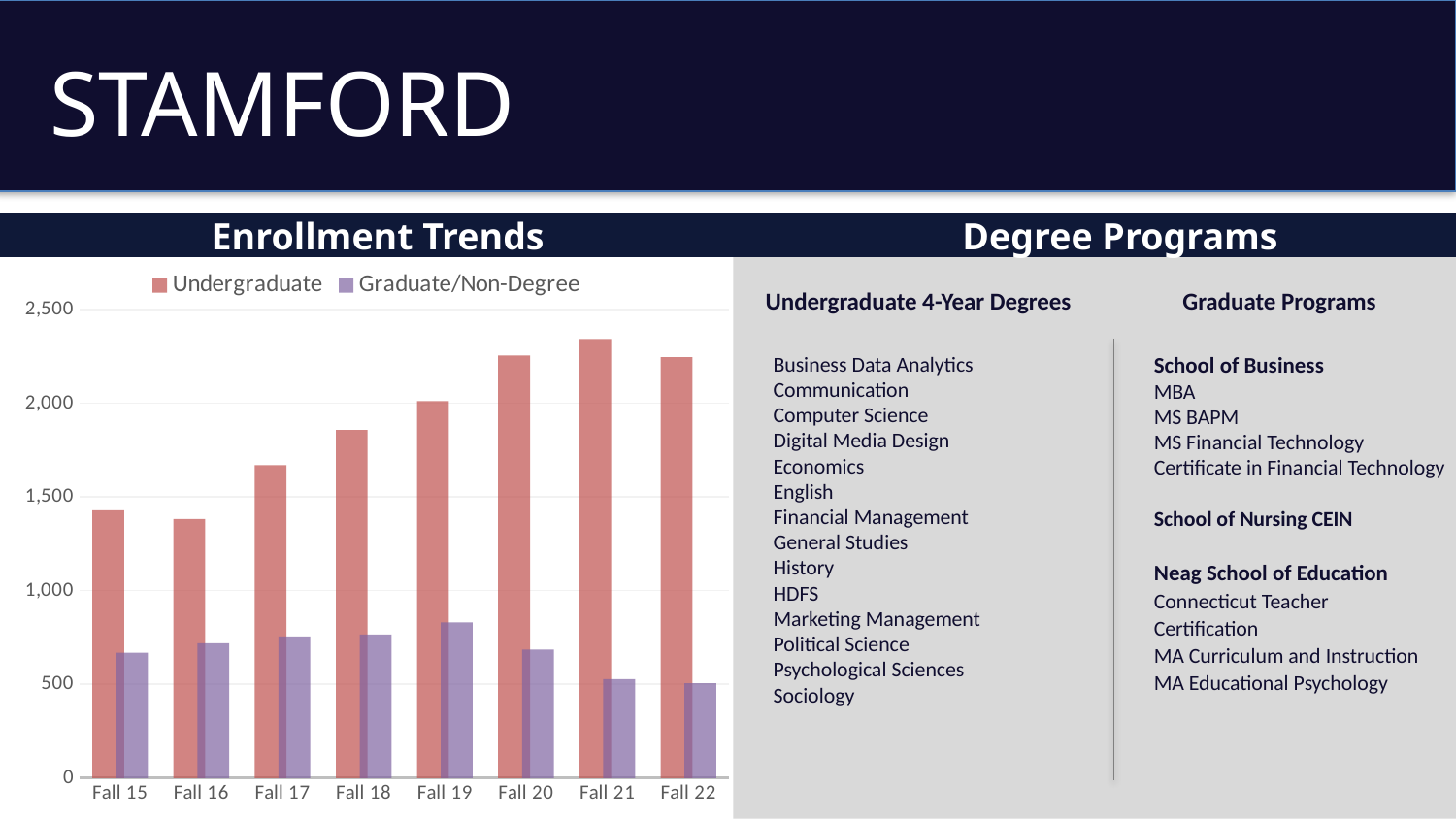
Which is larger: Graduate/Non-Degree enrollment in Fall 19 or in Fall 21? Fall 19 In which semester is Undergraduate enrollment highest in the Enrollment Trends chart? Fall 21 How many semesters are shown on the x axis of the Enrollment Trends chart? 8 How many series does the legend of the Enrollment Trends chart list? 2 Is the Undergraduate value for Fall 21 greater or less than 2,000? greater What kind of chart is shown under Enrollment Trends? Bar chart In which semester is Graduate/Non-Degree enrollment highest in the Enrollment Trends chart? Fall 19 Which is larger: Undergraduate enrollment in Fall 17 or in Fall 16? Fall 17 Is the Undergraduate value for Fall 15 greater or less than 1,500? less What are the two series named in the legend of the Enrollment Trends chart? Undergraduate and Graduate/Non-Degree In which semester is Undergraduate enrollment lowest in the Enrollment Trends chart? Fall 16 Is the Graduate/Non-Degree value for Fall 20 greater or less than 500? greater